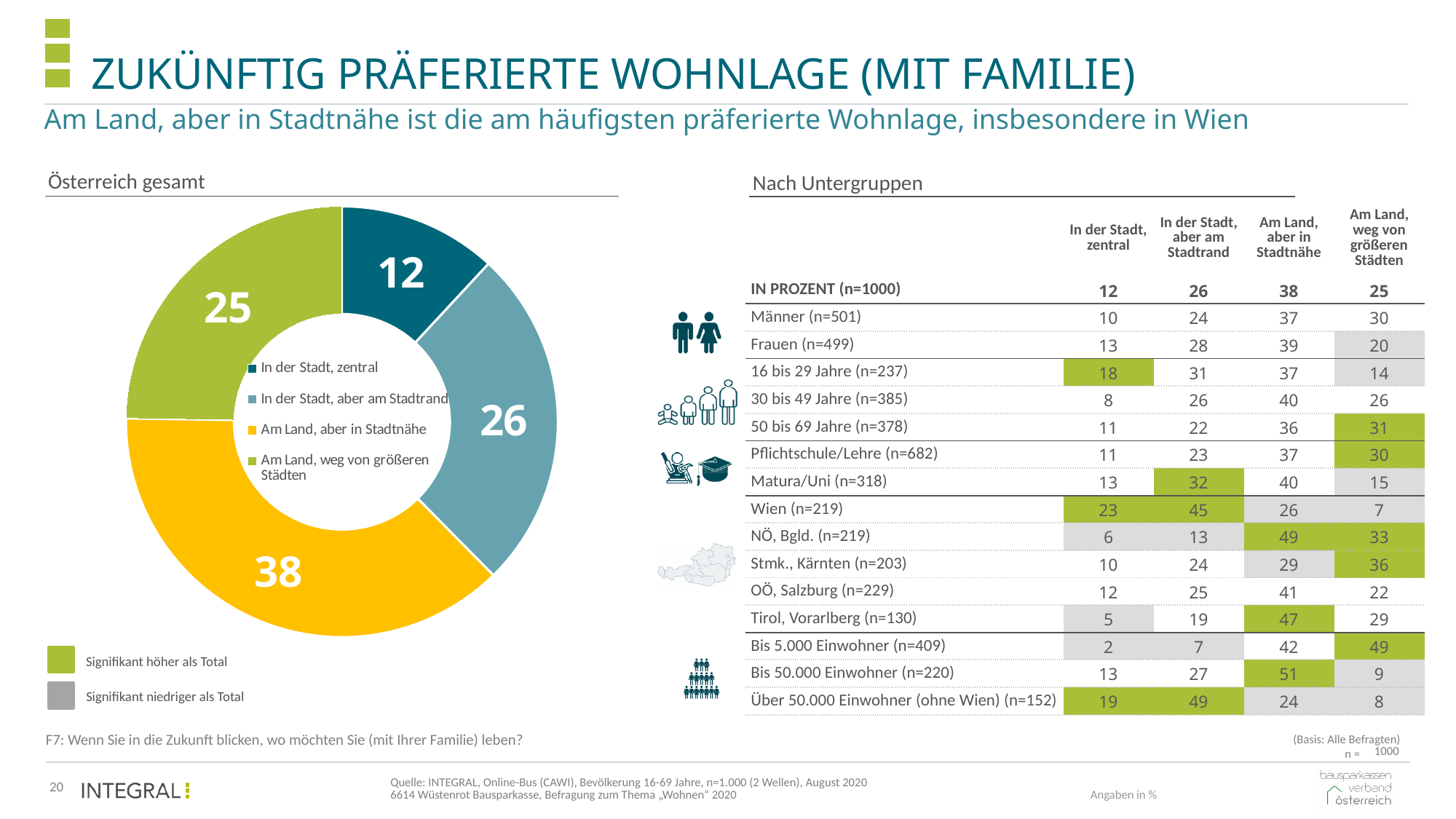
What kind of chart is the 'Österreich gesamt' chart? Donut (pie) chart In the 'Österreich gesamt' chart, which category has the lowest value? In der Stadt, zentral In the 'Österreich gesamt' chart, which category has the highest value? Am Land, aber in Stadtnähe In the 'Österreich gesamt' chart, which is larger: 'In der Stadt, aber am Stadtrand' or 'Am Land, weg von größeren Städten'? In der Stadt, aber am Stadtrand In the 'Österreich gesamt' chart, what is the value for 'Am Land, aber in Stadtnähe'? 38 In the 'Österreich gesamt' chart, what is the value for 'In der Stadt, zentral'? 12 In the 'Österreich gesamt' chart, what is the difference between 'Am Land, aber in Stadtnähe' and 'In der Stadt, zentral'? 26 In the 'Österreich gesamt' chart, what colour is the 'Am Land, aber in Stadtnähe' slice? Yellow How many categories does the 'Österreich gesamt' chart show? 4 In the 'Österreich gesamt' chart, what is the value for 'Am Land, weg von größeren Städten'? 25 In the 'Österreich gesamt' chart, what is the value for 'In der Stadt, aber am Stadtrand'? 26 In the 'Österreich gesamt' chart, what is the combined value of the two 'In der Stadt' categories? 38